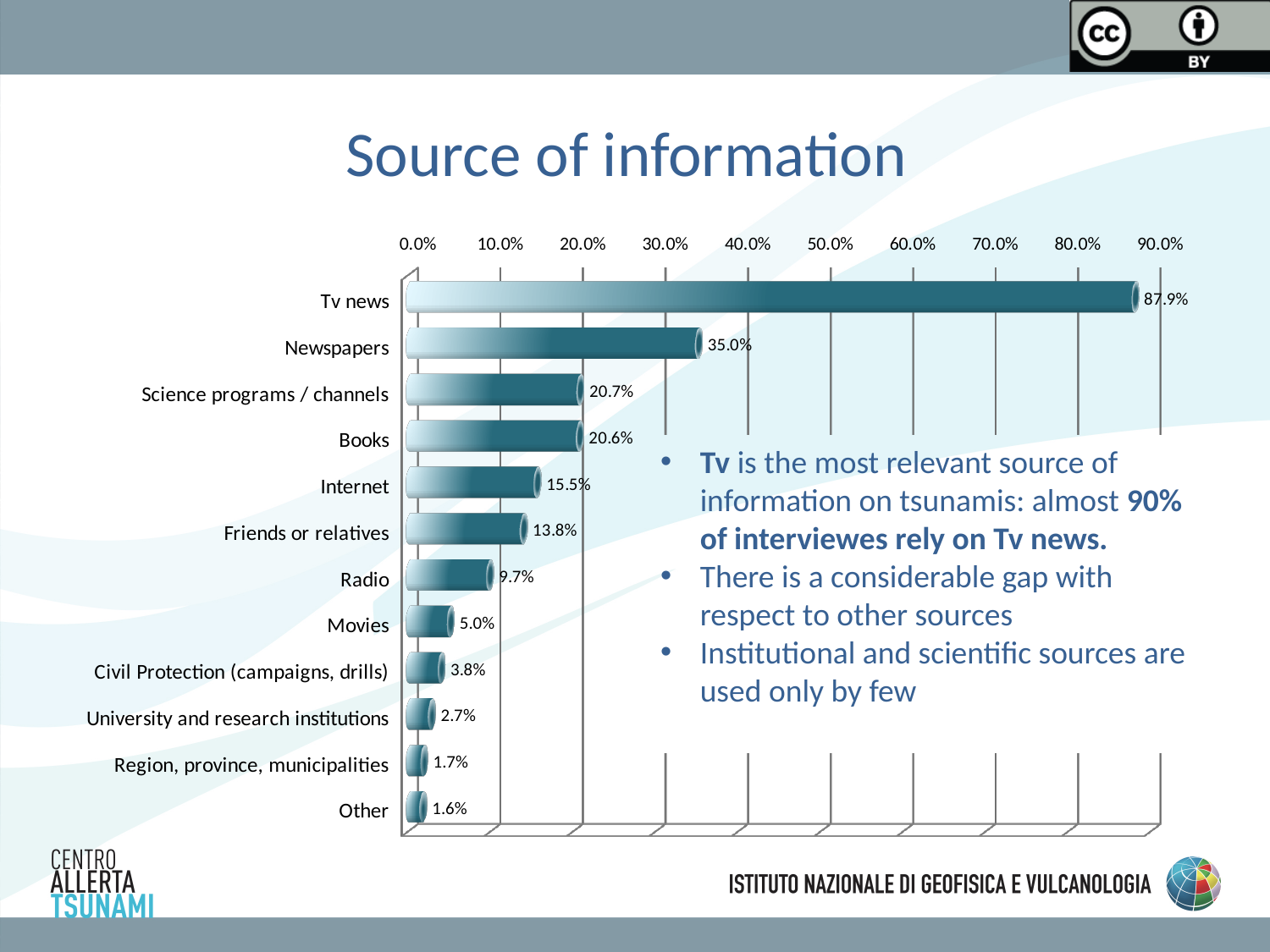
Which is larger, the value for Radio or the value for Movies? Radio What is the value for Internet? 15.5% Which source has the lowest value? Other Which source has the highest value? Tv news What is the title of the slide containing the chart? Source of information What is the difference between the values for Tv news and Newspapers? 52.9% What is the value for Civil Protection (campaigns, drills)? 3.8% What is the value for Tv news? 87.9% How many sources of information are shown in the chart? 12 Is the value for Friends or relatives greater or less than 10.0%? greater What is the value for Newspapers? 35.0% What kind of chart is shown on the slide? Bar chart